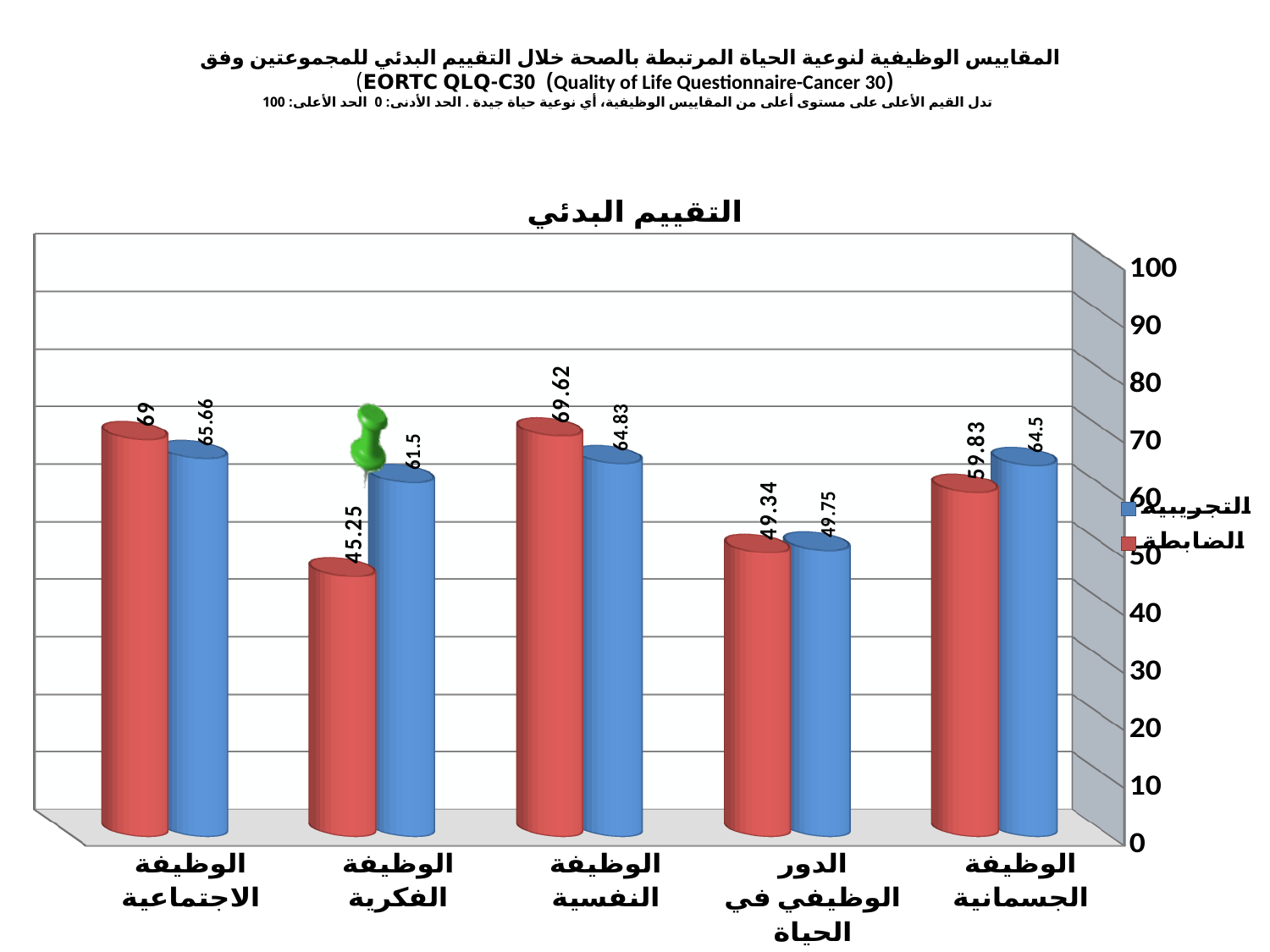
What is the value of the التجريبية (blue) series for الوظيفة الفكرية? 61.5 What is the value of the الضابطة (red) series for الوظيفة الاجتماعية? 69 What is the value of the التجريبية (blue) series for الوظيفة الجسمانية? 64.5 What is the title of the chart? التقييم البدئي For الوظيفة الجسمانية, which series has the larger value, التجريبية or الضابطة? التجريبية How many series does the chart legend list? 2 Which category has the lowest value for the الضابطة (red) series? الوظيفة الفكرية Which category has the highest value for the التجريبية (blue) series? الوظيفة الاجتماعية How many categories are shown on the x axis of the chart? 5 What type of chart is shown on the slide? bar chart What is the value of the الضابطة (red) series for الوظيفة النفسية? 69.62 What is the difference between the التجريبية and الضابطة values for الوظيفة الفكرية? 16.25